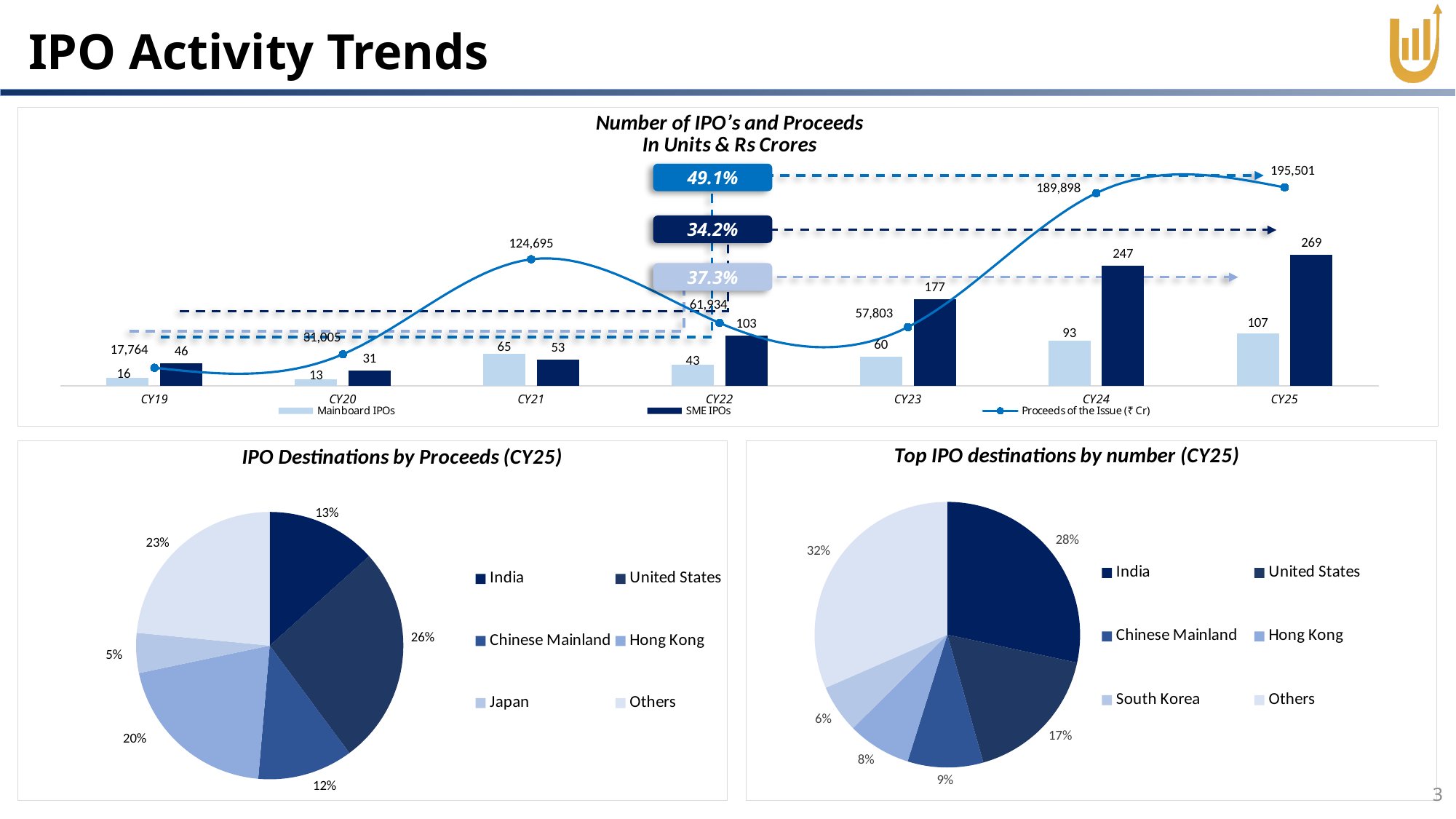
In the 'Number of IPO's and Proceeds' chart, what is the difference between the number of SME IPOs in CY25 and CY24? 22 In the 'Number of IPO's and Proceeds' chart, what were the proceeds of the issue in CY21? 124,695 In the 'Number of IPO's and Proceeds' chart, how many SME IPOs were there in CY25? 269 In the 'Number of IPO's and Proceeds' chart, which year has the lowest number of SME IPOs? CY20 In the 'Top IPO destinations by number (CY25)' pie chart, what share does India have? 28% What type of chart is 'Top IPO destinations by number (CY25)'? Pie chart In the 'Number of IPO's and Proceeds' chart, how many series does the legend list? 3 In the 'Number of IPO's and Proceeds' chart, which is larger: Mainboard IPOs in CY21 or SME IPOs in CY21? Mainboard IPOs in CY21 In the 'IPO Destinations by Proceeds (CY25)' pie chart, what share does the United States have? 26% In the 'Number of IPO's and Proceeds' chart, how many years are shown on the x axis? 7 In the 'Number of IPO's and Proceeds' chart, which year has the highest number of Mainboard IPOs? CY25 In the 'IPO Destinations by Proceeds (CY25)' pie chart, which destination has the smallest share? Japan